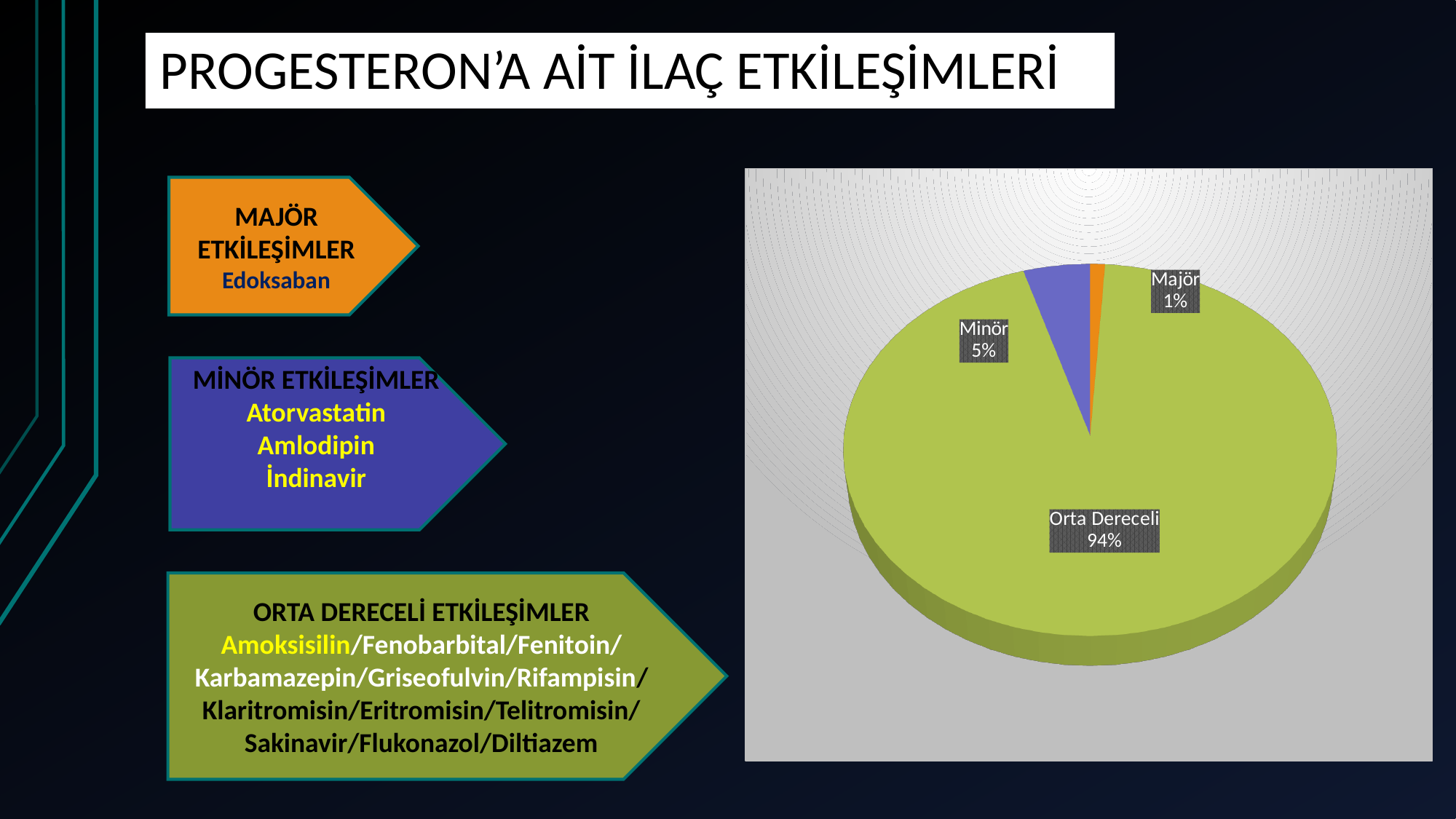
What percentage of the pie chart is labelled Orta Dereceli? 94% What percentage of the pie chart is labelled Majör? 1% Which slice is larger, Minör or Majör? Minör What kind of chart is shown on the slide? pie chart Which slice of the pie chart is the largest? Orta Dereceli What percentage of the pie chart is labelled Minör? 5% What colour is the Minör slice of the pie chart? blue What is the difference in percentage points between the Minör slice and the Majör slice? 4 Which slice of the pie chart is the smallest? Majör What colour is the Orta Dereceli slice of the pie chart? green What is the difference in percentage points between the Orta Dereceli slice and the Minör slice? 89 How many slices does the pie chart have? 3